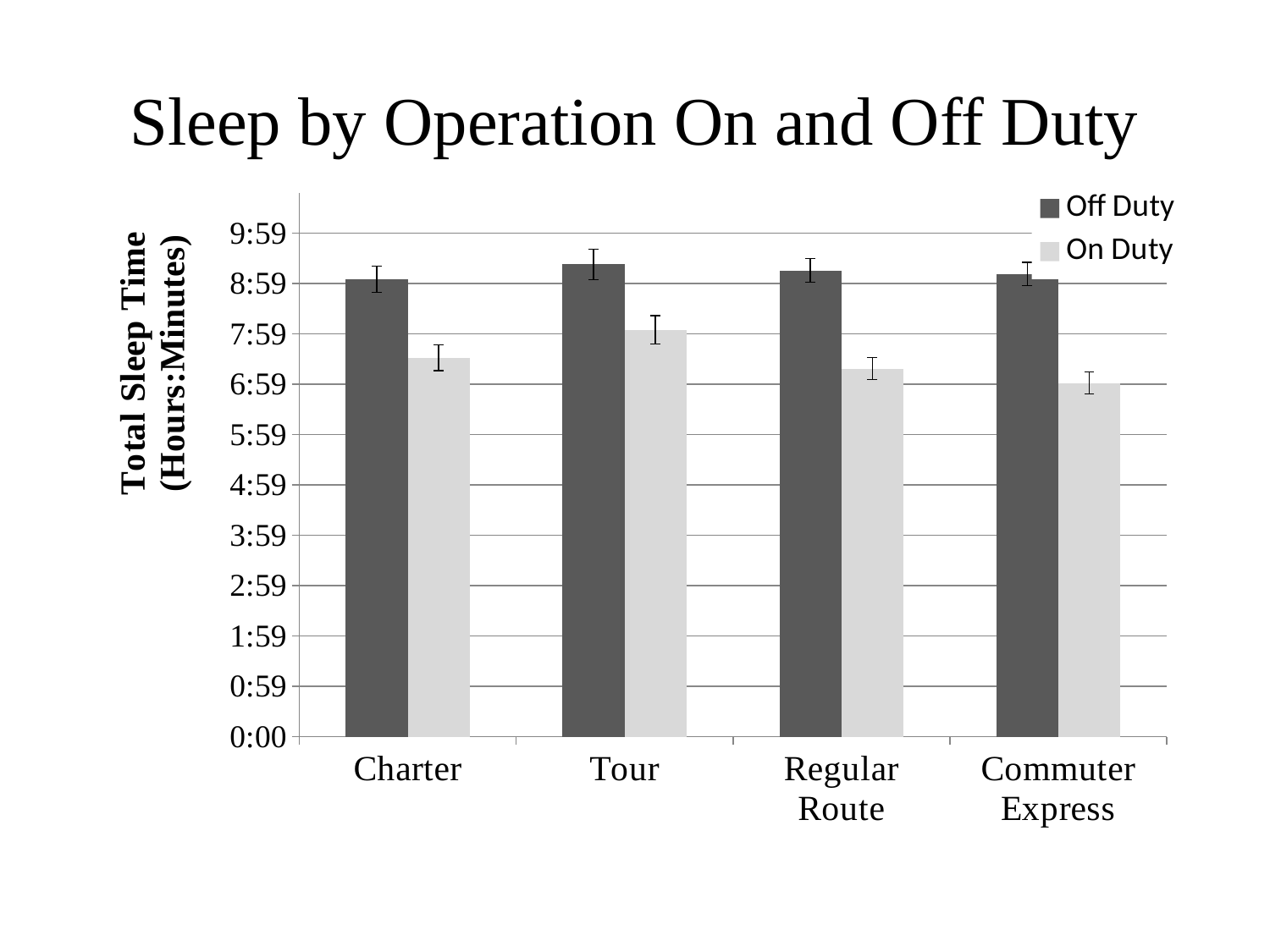
How many operation categories are shown on the x axis? 4 Which operation has the highest On Duty sleep time? Tour Is the Off Duty value for Commuter Express greater or less than 9:59? less How many series does the legend list? 2 For Charter, which is larger: the Off Duty value or the On Duty value? Off Duty Is the On Duty value for Charter greater or less than 6:59? greater What is the title of the chart? Sleep by Operation On and Off Duty What are the two series named in the legend? Off Duty and On Duty Is the On Duty value for Commuter Express greater or less than 7:59? less What kind of chart is shown on the slide? bar chart Which is larger: the On Duty value for Tour or the On Duty value for Regular Route? Tour